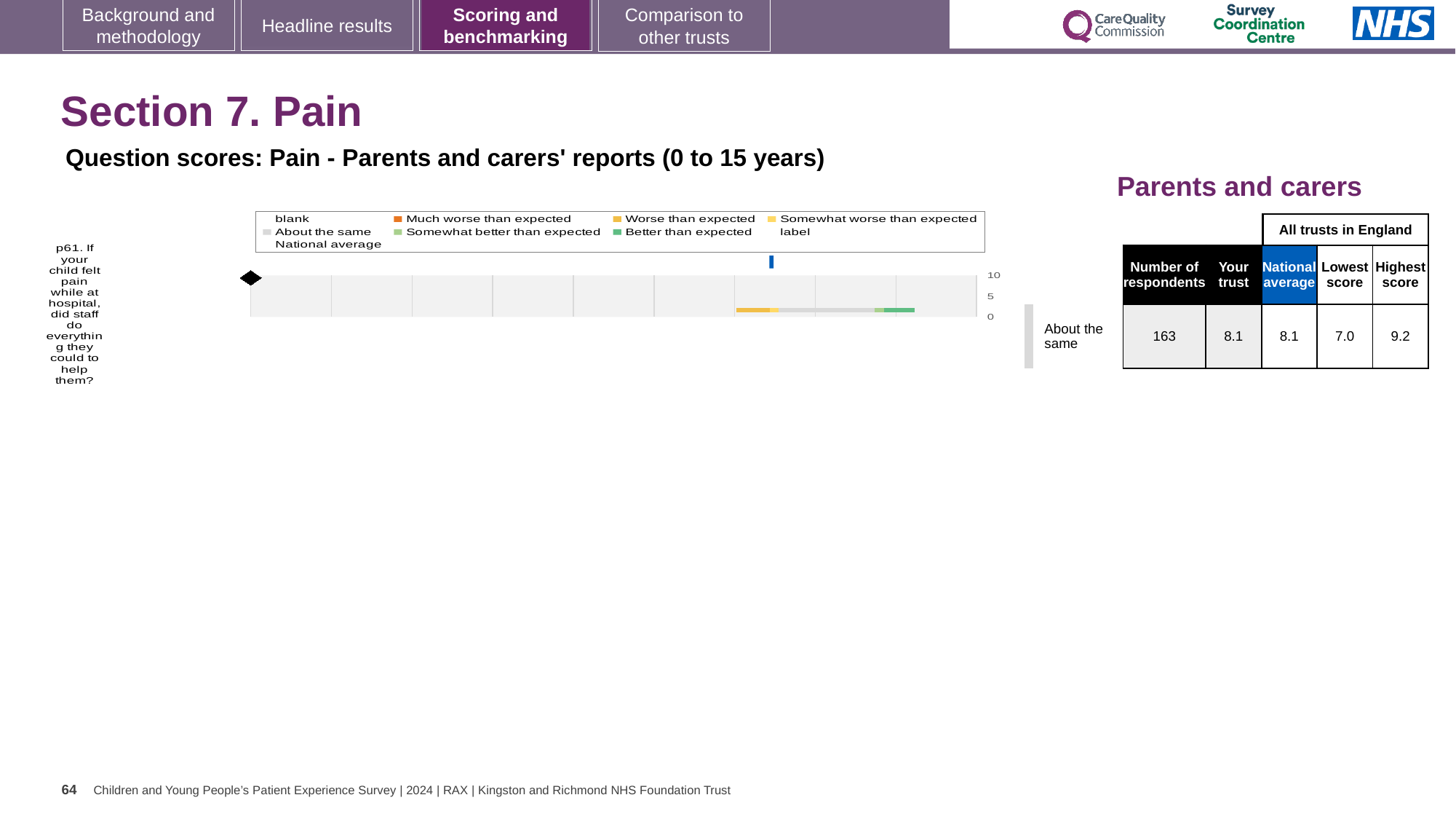
In the table beside the chart, what is the difference between the highest score and the lowest score? 2.2 What is the highest value shown on the chart's axis? 10 How many question categories are plotted on the chart? 1 In the table beside the chart, what is the national average score? 8.1 In the table beside the chart, what is the lowest score among all trusts in England? 7.0 What kind of chart is shown on the slide? bar chart In the table beside the chart, what is the 'Your trust' score for the 'About the same' row? 8.1 Which question is plotted on the chart? p61. If your child felt pain while at hospital, did staff do everything they could to help them? How many entries does the chart legend list? 9 Is the national average marker on the chart greater or less than 5? greater In the table beside the chart, what is the number of respondents? 163 In the table beside the chart, which is larger: the highest score or the 'Your trust' score? Highest score